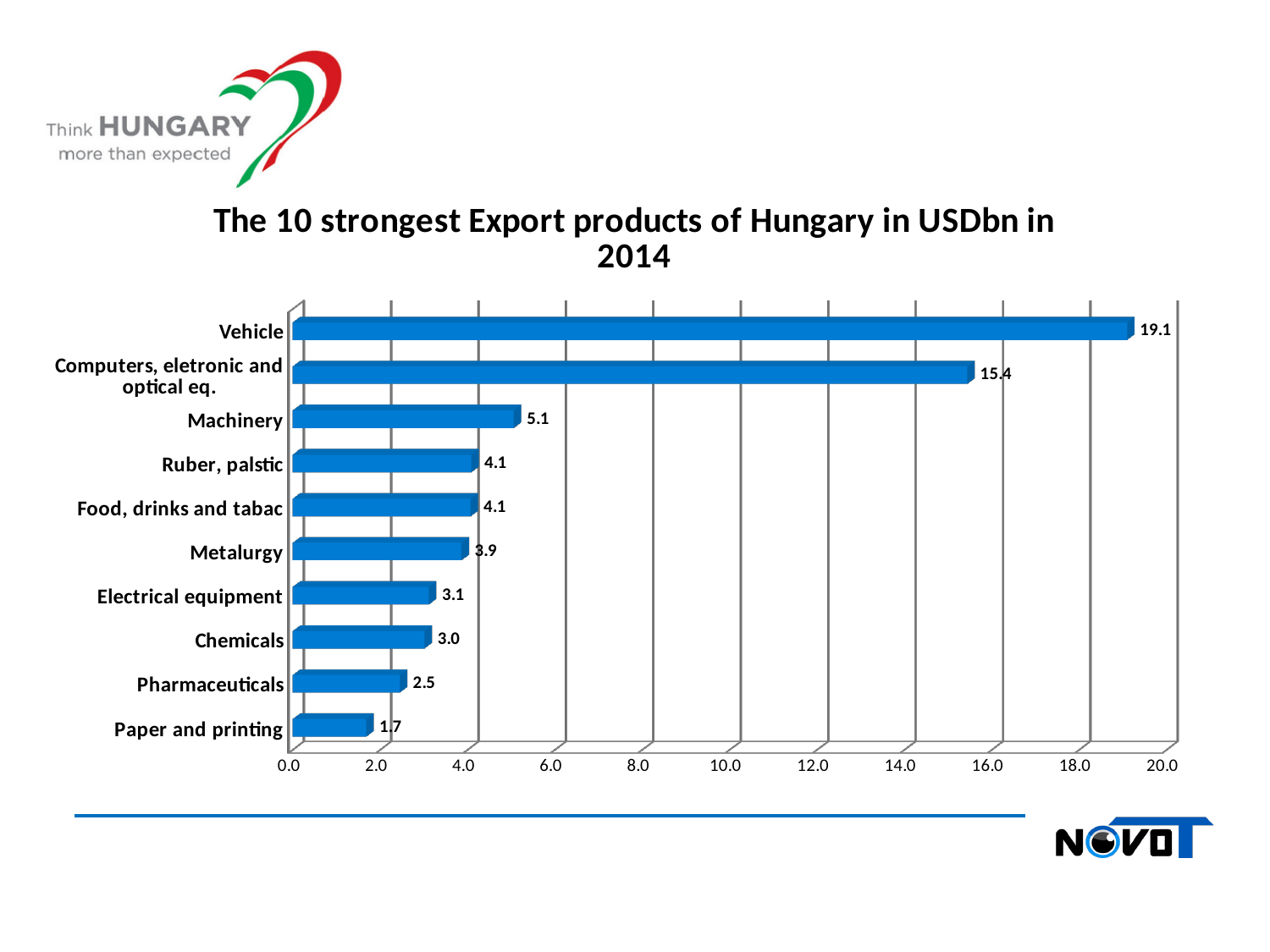
What is the export value for Machinery? 5.1 What is the export value for Pharmaceuticals? 2.5 What kind of chart is shown on the slide? Bar chart What is the export value for Vehicle? 19.1 Which is larger, the value for Electrical equipment or the value for Pharmaceuticals? Electrical equipment What is the difference between the values for Vehicle and Computers, eletronic and optical eq.? 3.7 What is the difference between the values for Machinery and Metalurgy? 1.2 Which export product has the highest value? Vehicle What is the title of the chart? The 10 strongest Export products of Hungary in USDbn in 2014 Which export product has the lowest value? Paper and printing What is the export value for Computers, eletronic and optical eq.? 15.4 How many export product categories are shown in the chart? 10